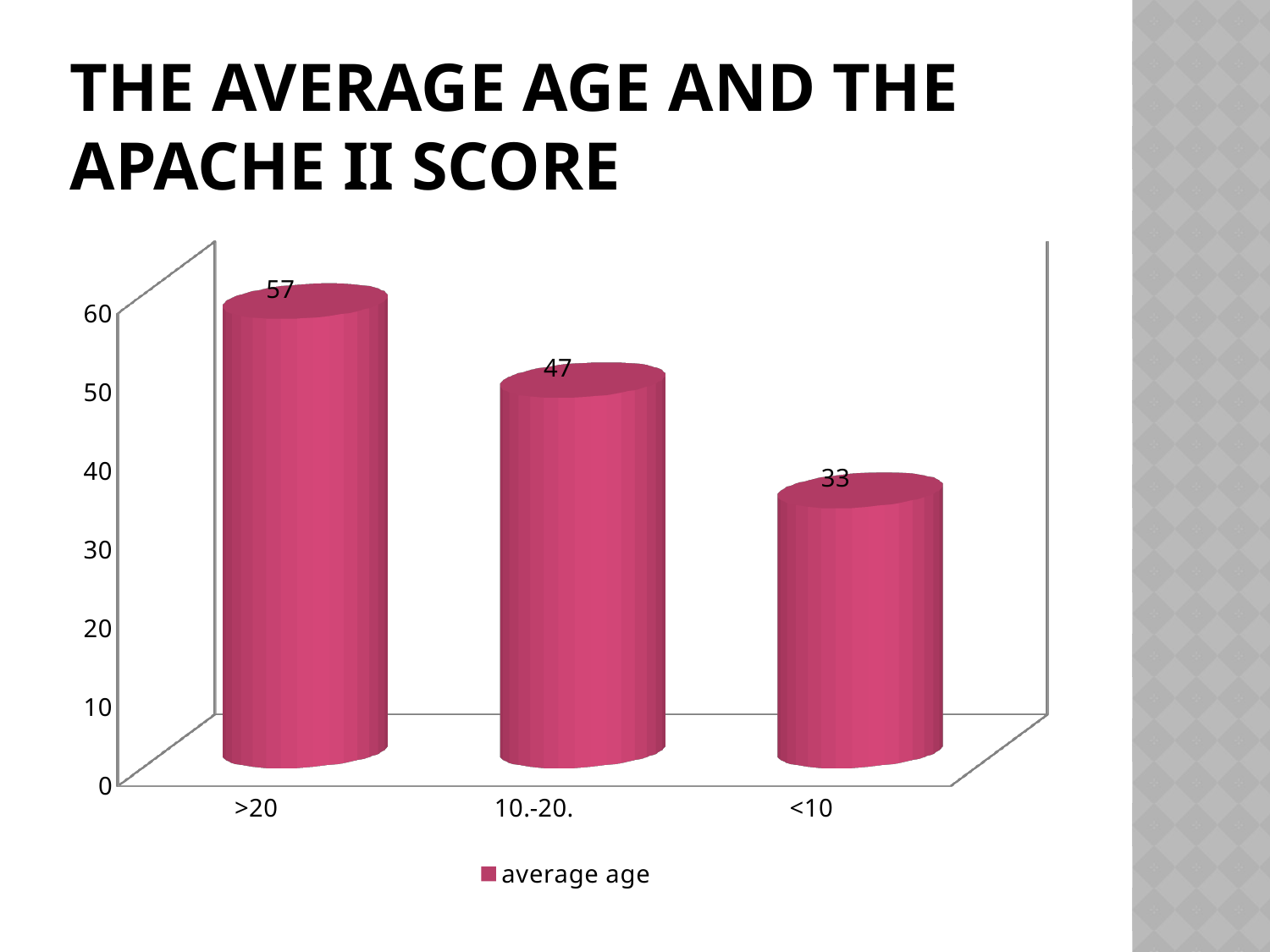
Which APACHE II score category has the lowest average age? <10 What kind of chart is shown on the slide? bar chart Do the average age values rise or fall from left to right across the categories? fall What is the average age for the APACHE II score category <10? 33 What is the average age for the APACHE II score category >20? 57 Which APACHE II score category has the highest average age? >20 What is the difference in average age between the >20 and <10 categories? 24 Which has a higher average age, the 10.-20. category or the <10 category? 10.-20. How many series does the legend list? 1 What is the difference in average age between the >20 and 10.-20. categories? 10 What is the average age for the APACHE II score category 10.-20.? 47 How many APACHE II score categories are shown on the chart? 3